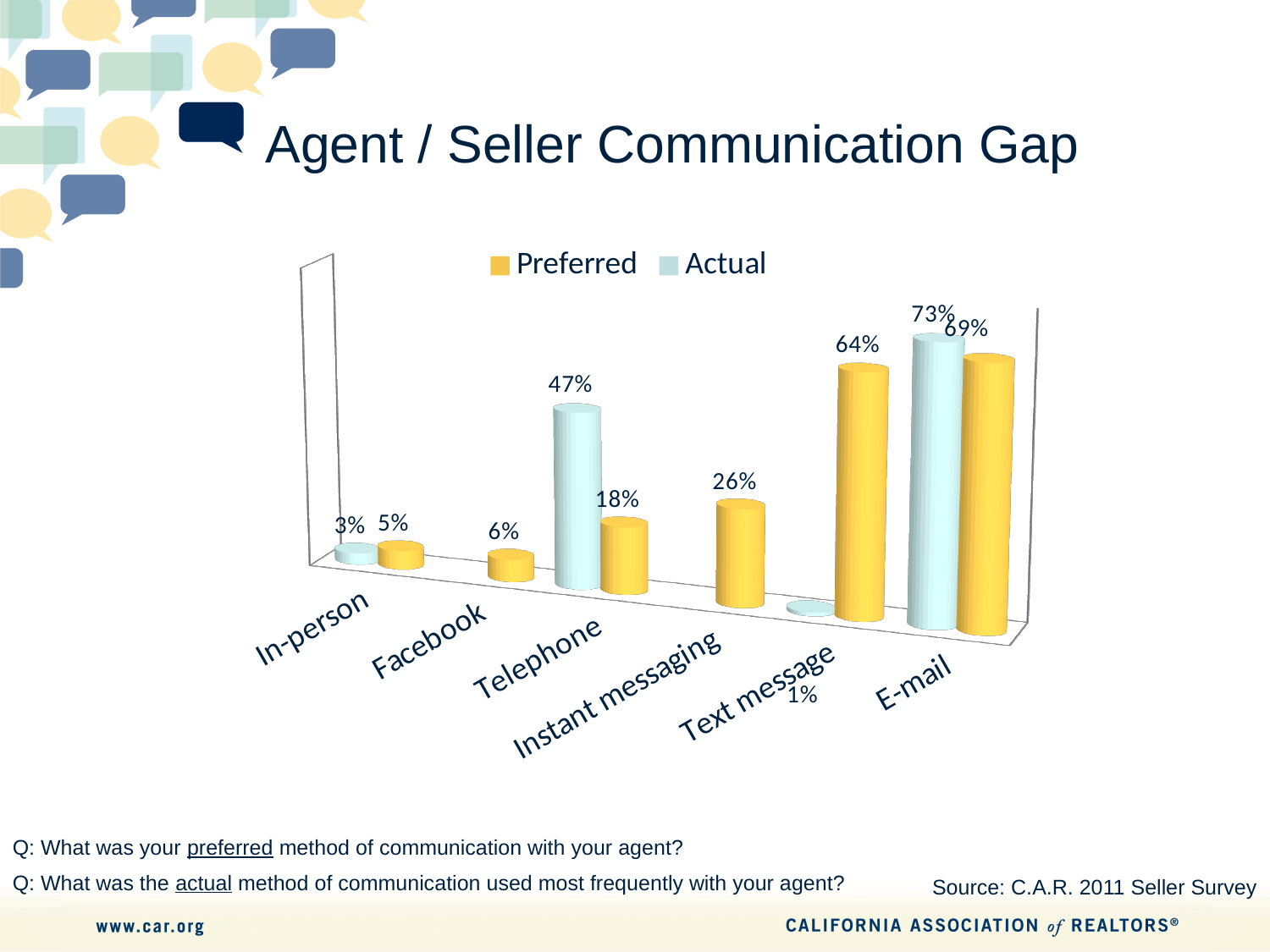
What is the Preferred value for Text message? 64% What is the title of the slide? Agent / Seller Communication Gap What is the Preferred value for Telephone? 18% What kind of chart is shown on the slide? Bar chart What is the difference between the Actual and Preferred values for Telephone? 29% What is the Actual value for Telephone? 47% Which category has the lowest Actual value among those with a labelled Actual bar? Text message How many categories are shown on the x axis? 6 How many series does the legend list? 2 What is the Actual value for E-mail? 73% Which is larger for E-mail, the Preferred value or the Actual value? Actual Which category has the highest Preferred value? E-mail